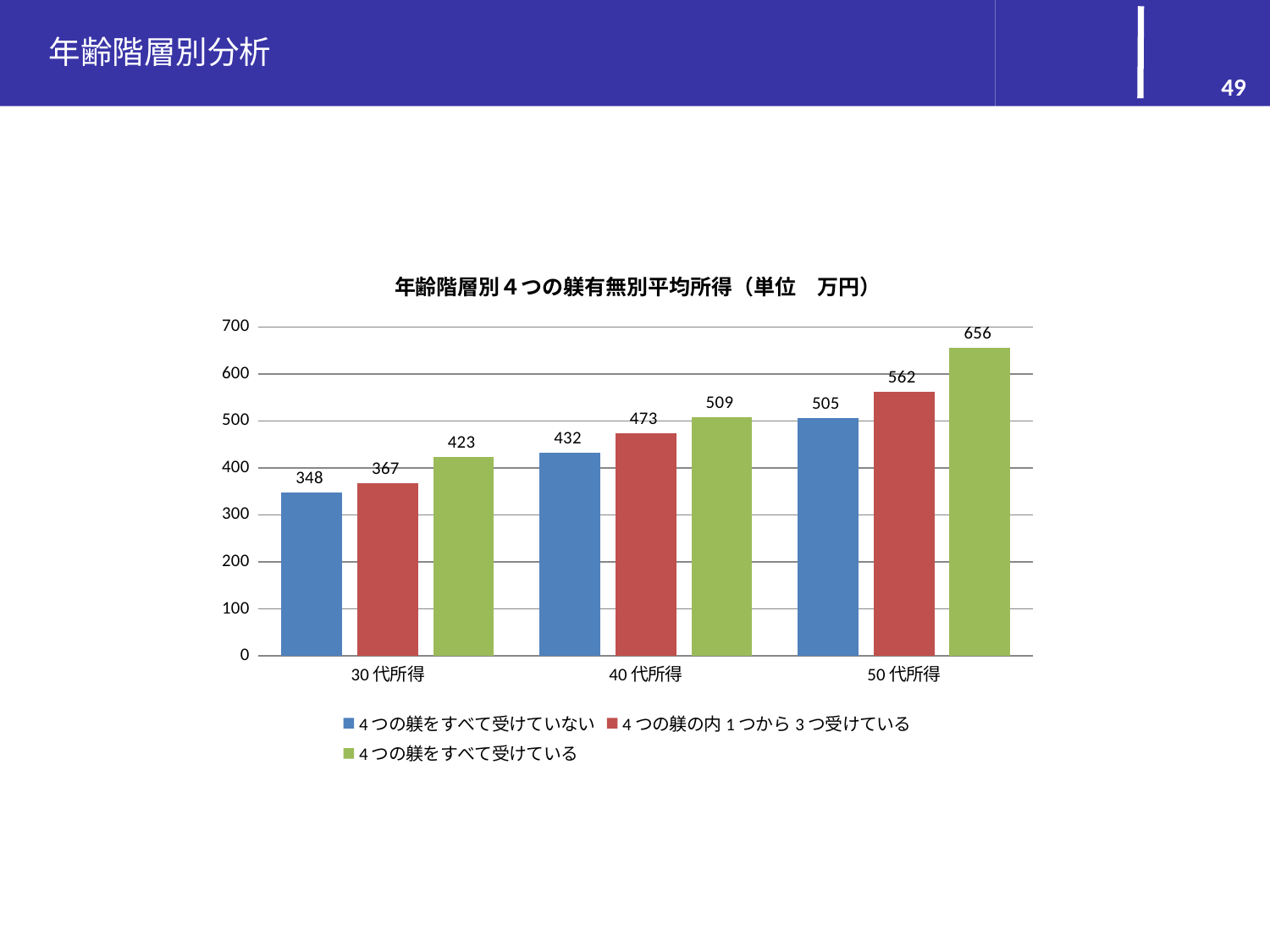
What is the value for 40代所得 in the series 4つの躾の内1つから3つ受けている? 473 What kind of chart is shown on the slide? bar chart What is the value for 50代所得 in the series 4つの躾をすべて受けている? 656 Which age category has the highest value in the series 4つの躾をすべて受けている? 50代所得 What is the value for 30代所得 in the series 4つの躾をすべて受けていない? 348 Is the value for 50代所得 in the series 4つの躾の内1つから3つ受けている greater or less than 500? greater Do the values in the series 4つの躾をすべて受けている rise or fall from 30代所得 to 50代所得? rise How many age categories are shown on the x axis? 3 What is the difference between the 4つの躾をすべて受けている value and the 4つの躾をすべて受けていない value for 50代所得? 151 Which age category has the lowest value in the series 4つの躾をすべて受けていない? 30代所得 Which is larger for 40代所得: the value for 4つの躾をすべて受けている or the value for 4つの躾をすべて受けていない? 4つの躾をすべて受けている How many series does the legend list? 3